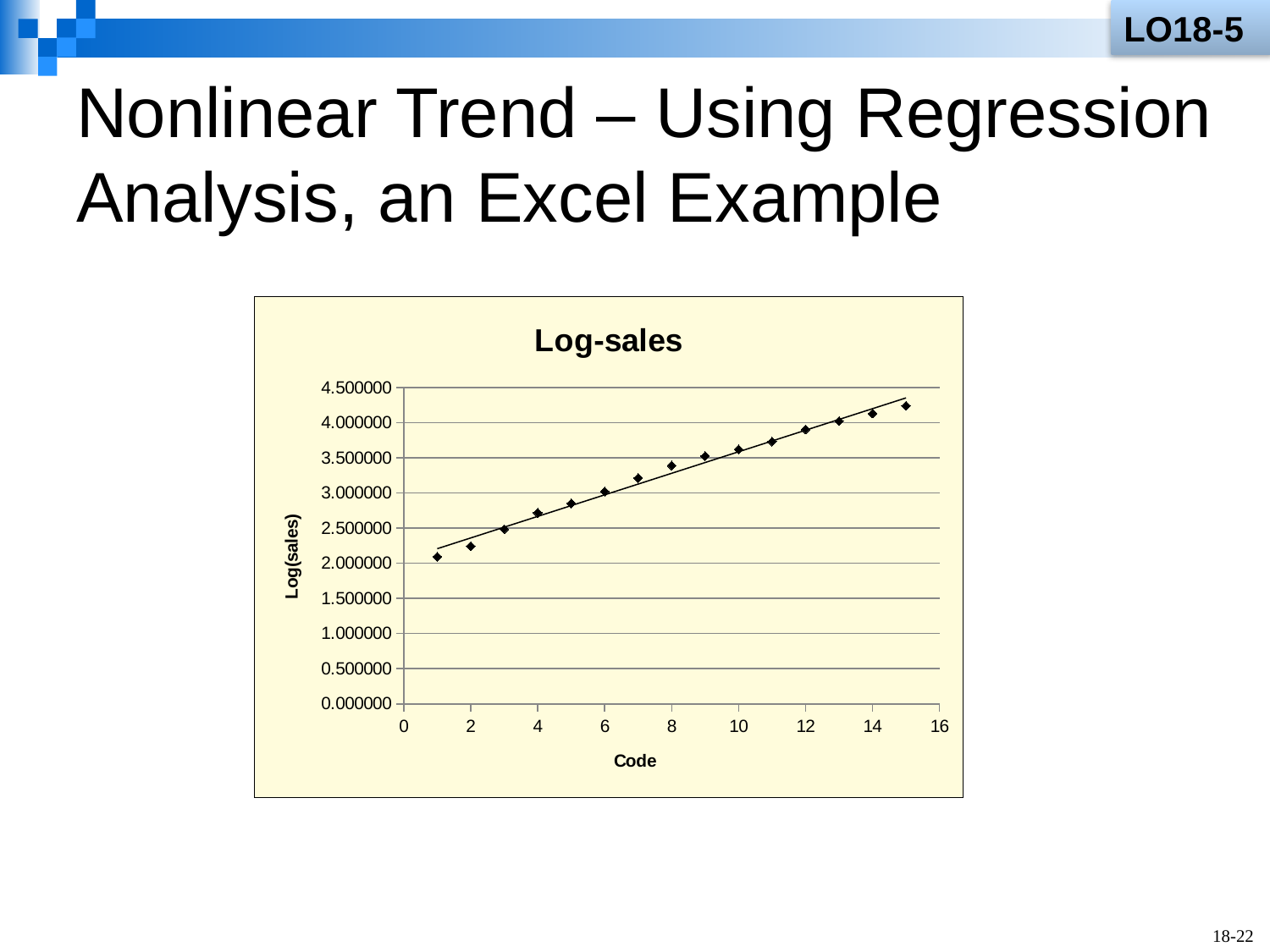
Is the Log(sales) value for Code 4 greater or less than 3.000000? less What is the title of the chart? Log-sales What is the label on the x axis of the chart? Code How many data points are plotted in the chart? 15 What kind of chart is shown on the slide? Scatter chart Which Code has the lowest Log(sales) value? 1 Which Code has the highest Log(sales) value? 15 Is the Log(sales) value for Code 8 greater or less than 3.000000? greater Do the Log(sales) values rise or fall as Code increases? Rise Is the Log(sales) value for Code 15 greater or less than 4.000000? greater Which has the larger Log(sales) value, Code 3 or Code 12? Code 12